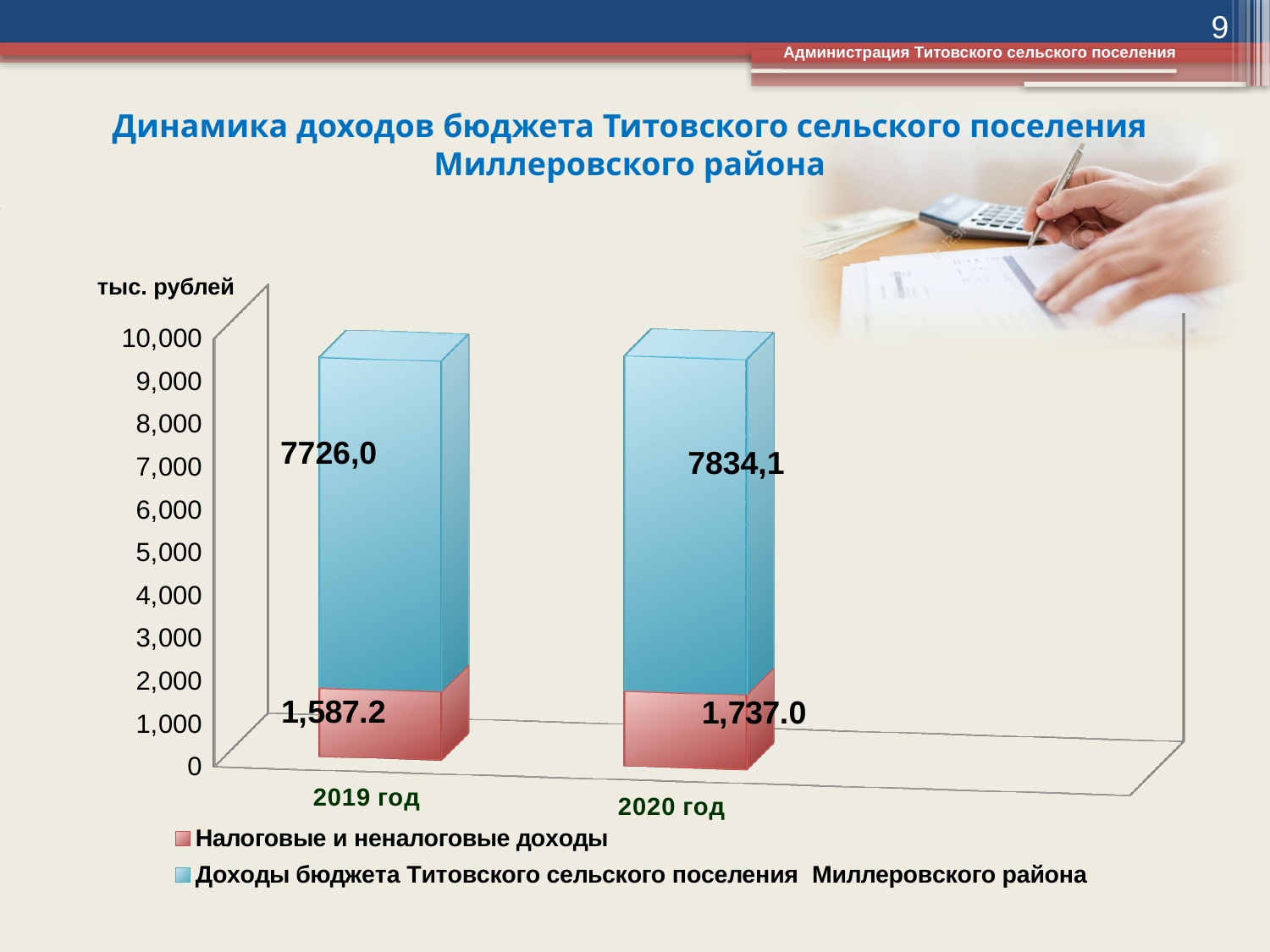
What is the value of the 'Налоговые и неналоговые доходы' series for 2020 год? 1,737.0 Which year has the lower value for 'Доходы бюджета Титовского сельского поселения Миллеровского района'? 2019 год By how much did the 'Доходы бюджета Титовского сельского поселения Миллеровского района' value increase from 2019 год to 2020 год? 108,1 Which year has the higher value for 'Налоговые и неналоговые доходы'? 2020 год What is the value of the 'Налоговые и неналоговые доходы' series for 2019 год? 1,587.2 What is the value of the 'Доходы бюджета Титовского сельского поселения Миллеровского района' series for 2020 год? 7834,1 What unit is indicated on the vertical axis of the chart? тыс. рублей What type of chart is shown on the slide? Stacked bar chart How many series does the chart legend list? 2 How many years (categories) are shown on the x axis of the chart? 2 What is the difference between the 'Налоговые и неналоговые доходы' values for 2020 год and 2019 год? 149.8 What is the value of the 'Доходы бюджета Титовского сельского поселения Миллеровского района' series for 2019 год? 7726,0